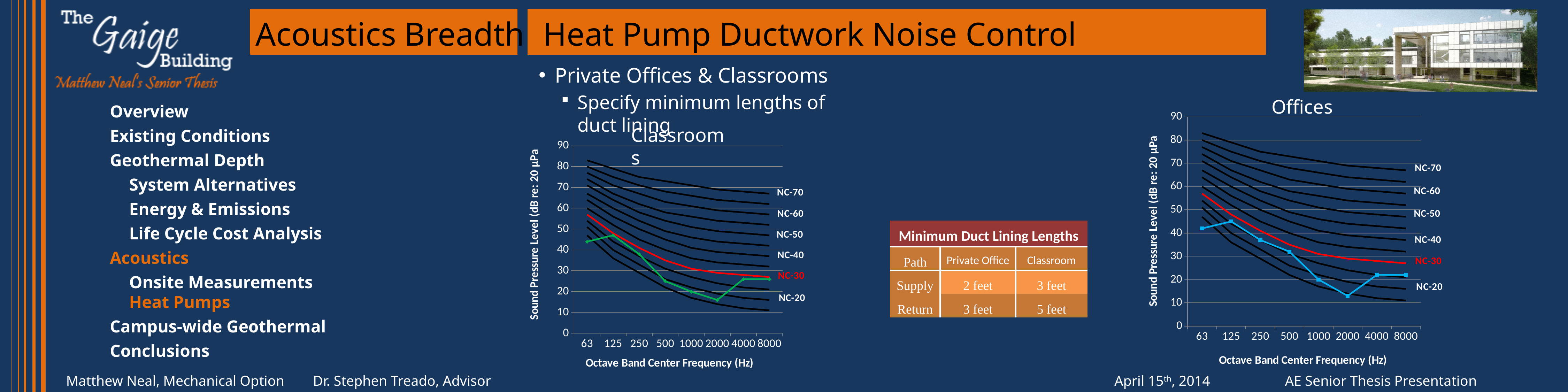
What kind of chart is the Classrooms chart? line chart In the Classrooms chart, at which frequency is the green measured line lowest? 2000 Hz In the Classrooms chart, is the green line's value at 63 Hz greater or less than 40? greater In the Offices chart, at which frequency is the blue measured line lowest? 2000 Hz In the Offices chart, is the blue line's value at 2000 Hz greater or less than 20? less In the Classrooms chart, is the green line's value at 2000 Hz greater or less than 20? less What kind of chart is the Offices chart? line chart Which NC curve label is shown in red on the Offices chart? NC-30 What is the y-axis title of the Classrooms chart? Sound Pressure Level (dB re: 20 μPa) In the Offices chart, does the blue line rise or fall from 125 Hz to 2000 Hz? fall How many octave band center frequencies are shown on the x axis of the Offices chart? 8